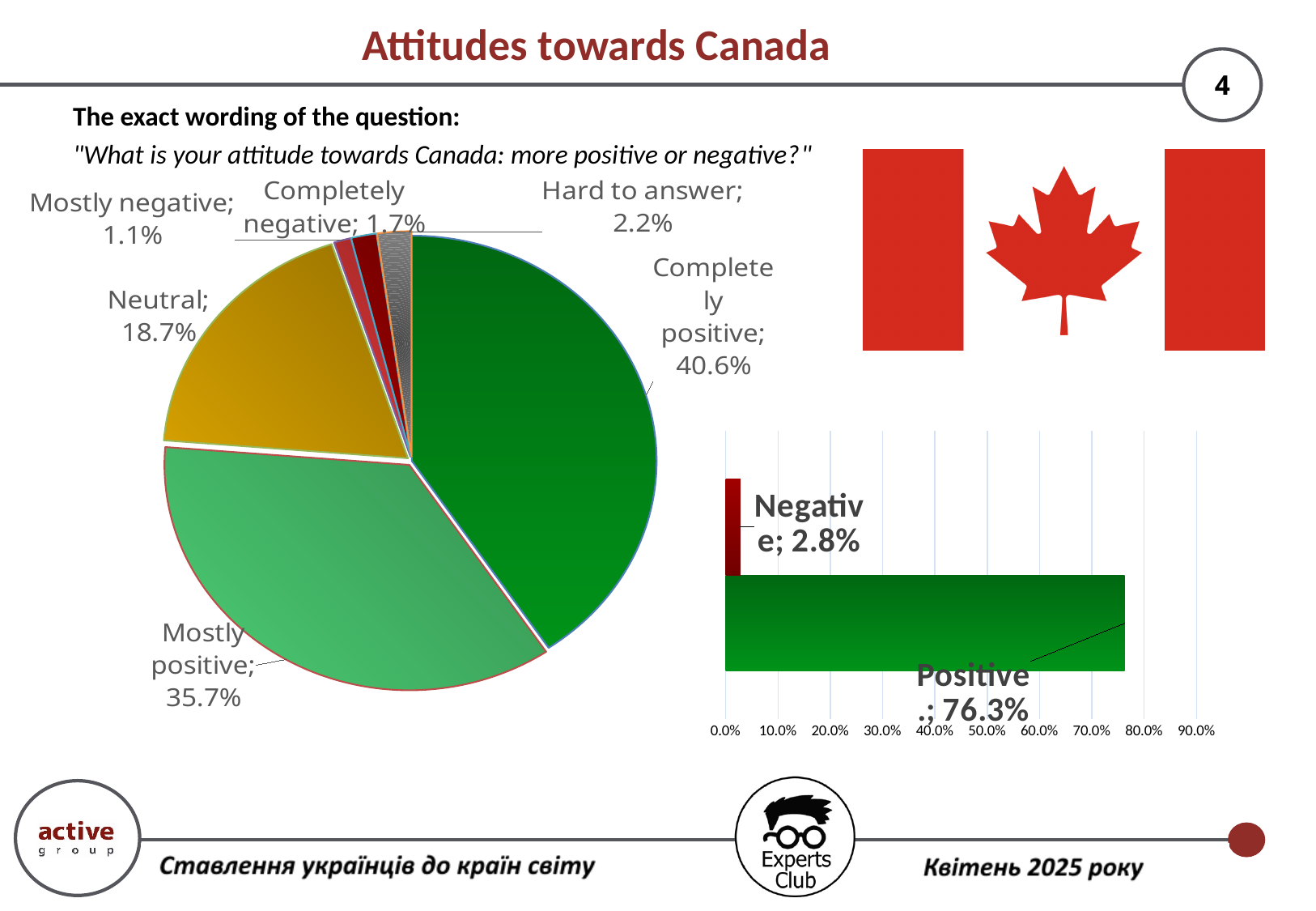
In the pie chart, which category has the largest slice? Completely positive In the pie chart, what is the value for Neutral? 18.7% In the pie chart, what share of respondents are completely positive towards Canada? 40.6% How many categories does the pie chart show? 6 What kind of chart is shown on the right side of the slide? Bar chart In the bar chart on the right, what is the value for Negative? 2.8% In the bar chart on the right, what is the difference between Positive and Negative? 73.5% In the pie chart, what is the value for Mostly negative? 1.1% In the pie chart, what is the difference between Completely positive and Mostly positive? 4.9% In the pie chart, which category has the smallest slice? Mostly negative In the pie chart, which is larger: Hard to answer or Completely negative? Hard to answer In the bar chart on the right, what is the value for Positive? 76.3%